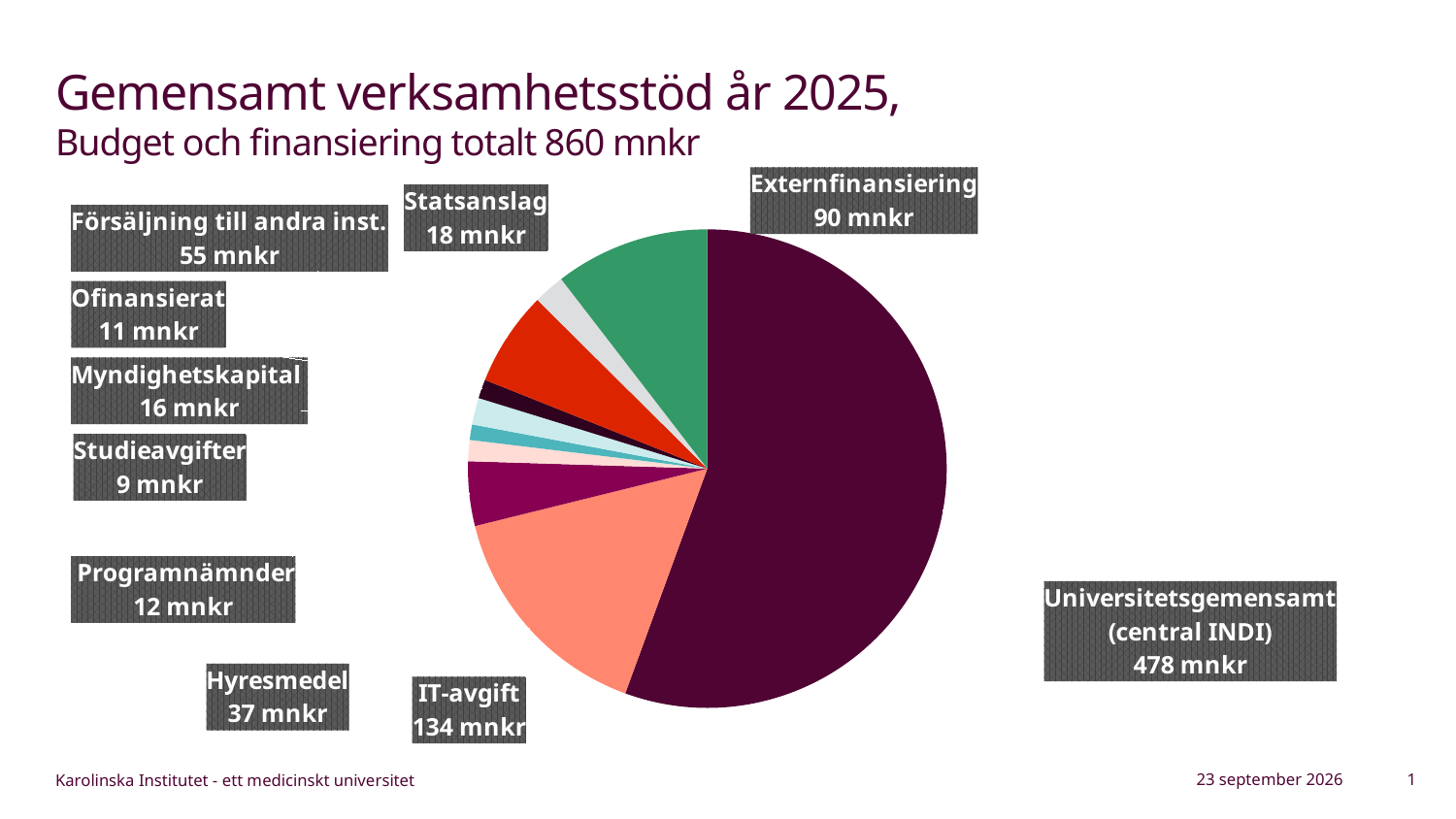
Which category has the largest slice of the pie? Universitetsgemensamt (central INDI) What is the total budget and financing stated in the slide subtitle? 860 mnkr What is the difference between Universitetsgemensamt (central INDI) and IT-avgift? 344 mnkr What kind of chart is shown on the slide? Pie chart What is the value for Hyresmedel? 37 mnkr How many categories are shown in the pie chart? 10 Which category has the smallest slice of the pie? Studieavgifter What is the value for Studieavgifter? 9 mnkr What is the difference between Externfinansiering and Försäljning till andra inst.? 35 mnkr Which is larger, Statsanslag or Myndighetskapital? Statsanslag What is the value for IT-avgift? 134 mnkr What is the value for Universitetsgemensamt (central INDI)? 478 mnkr